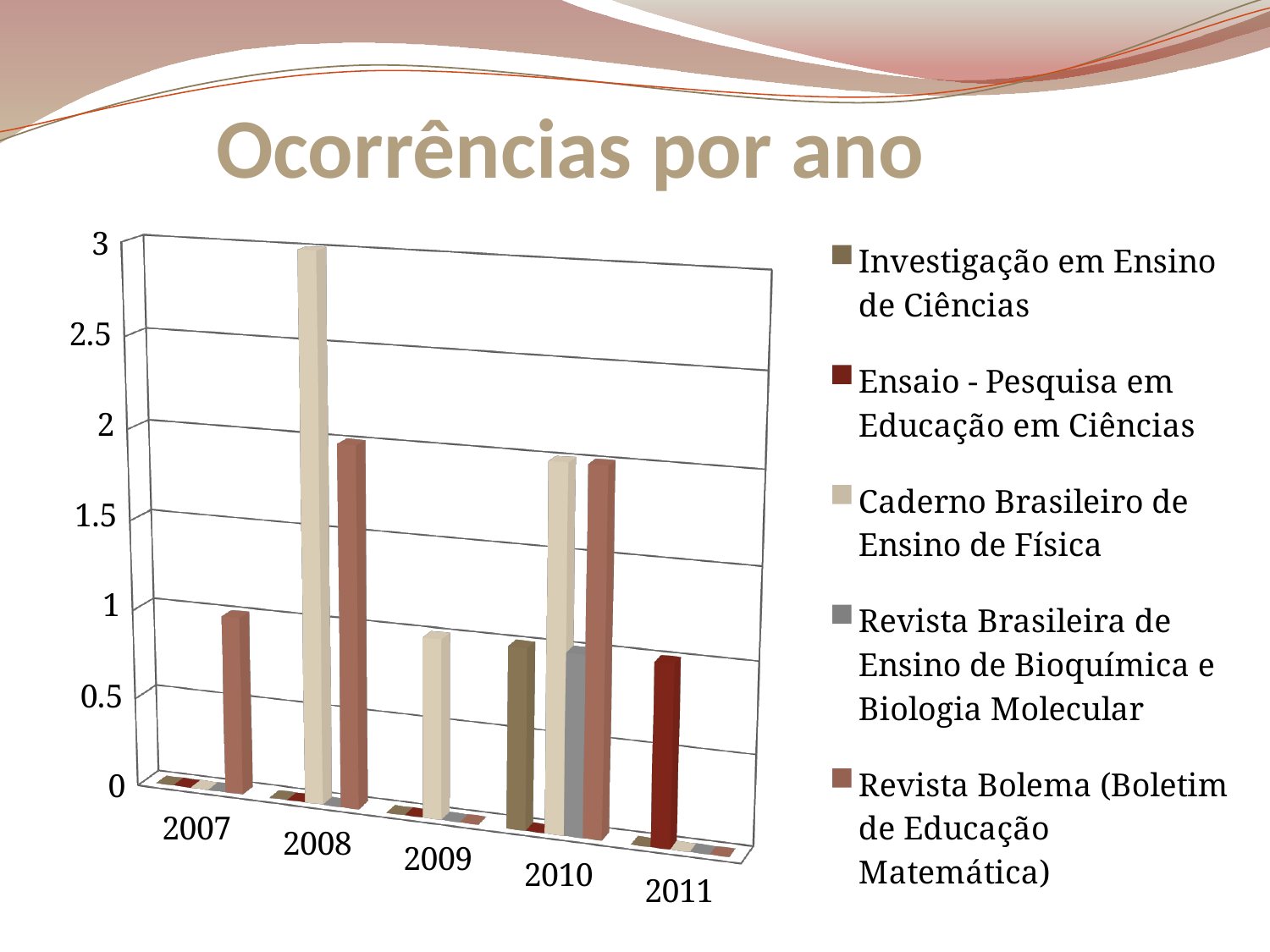
In 2010, which is larger: the bar for Caderno Brasileiro de Ensino de Física or the bar for Revista Brasileira de Ensino de Bioquímica e Biologia Molecular? Caderno Brasileiro de Ensino de Física What type of chart is shown on the slide? bar chart How many series does the chart's legend list? 5 In which year does the tallest bar of the whole chart appear? 2008 Which series has the tallest bar in 2008? Caderno Brasileiro de Ensino de Física Is the value for Caderno Brasileiro de Ensino de Física in 2009 greater or less than 1.5? less Is the value for Revista Bolema (Boletim de Educação Matemática) in 2007 greater or less than 1.5? less What is the title of the chart? Ocorrências por ano Is the value for Revista Bolema (Boletim de Educação Matemática) in 2008 greater or less than 1.5? greater Which series is shown in gray in the legend? Revista Brasileira de Ensino de Bioquímica e Biologia Molecular How many years are shown on the x axis of the chart? 5